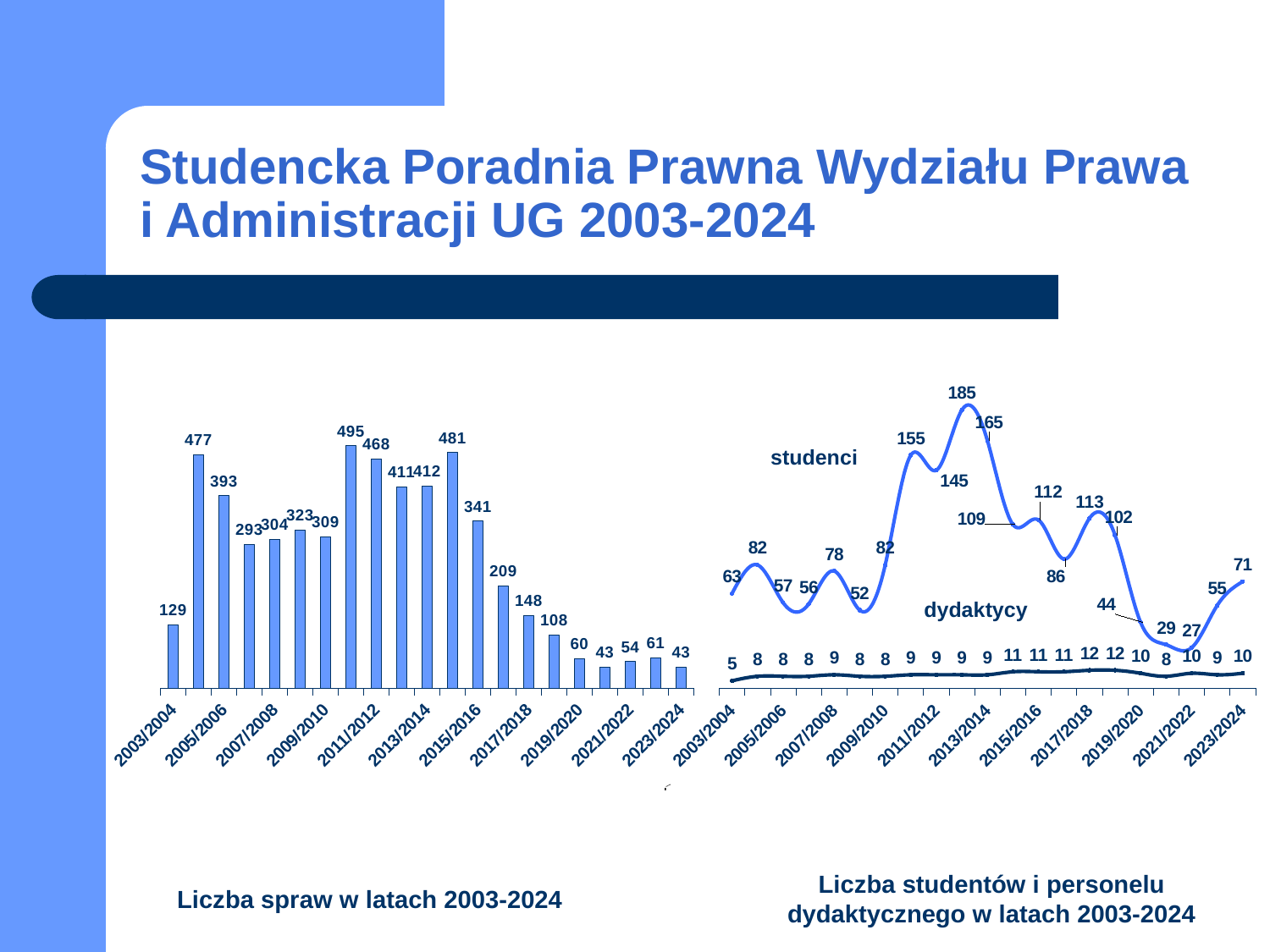
In the left chart 'Liczba spraw w latach 2003-2024', do the values rise or fall from 2015/2016 to 2019/2020? fall In the left chart 'Liczba spraw w latach 2003-2024', what is the difference between the values for 2015/2016 and 2023/2024? 298 In the left chart 'Liczba spraw w latach 2003-2024', which is larger: the value for 2005/2006 or for 2013/2014? 2013/2014 In the right chart 'Liczba studentów i personelu dydaktycznego w latach 2003-2024', what is the lowest value of the dydaktycy series? 5 In the right chart 'Liczba studentów i personelu dydaktycznego w latach 2003-2024', what is the highest value of the studenci series? 185 In the right chart 'Liczba studentów i personelu dydaktycznego w latach 2003-2024', what is the value of dydaktycy for 2017/2018? 12 How many series are plotted in the right chart 'Liczba studentów i personelu dydaktycznego w latach 2003-2024'? 2 In the left chart 'Liczba spraw w latach 2003-2024', what is the value for 2003/2004? 129 In the left chart 'Liczba spraw w latach 2003-2024', what is the value for 2023/2024? 43 What kind of chart is the left chart titled 'Liczba spraw w latach 2003-2024'? bar chart In the right chart 'Liczba studentów i personelu dydaktycznego w latach 2003-2024', what is the value of studenci for 2013/2014? 165 In the left chart 'Liczba spraw w latach 2003-2024', what is the highest value shown? 495